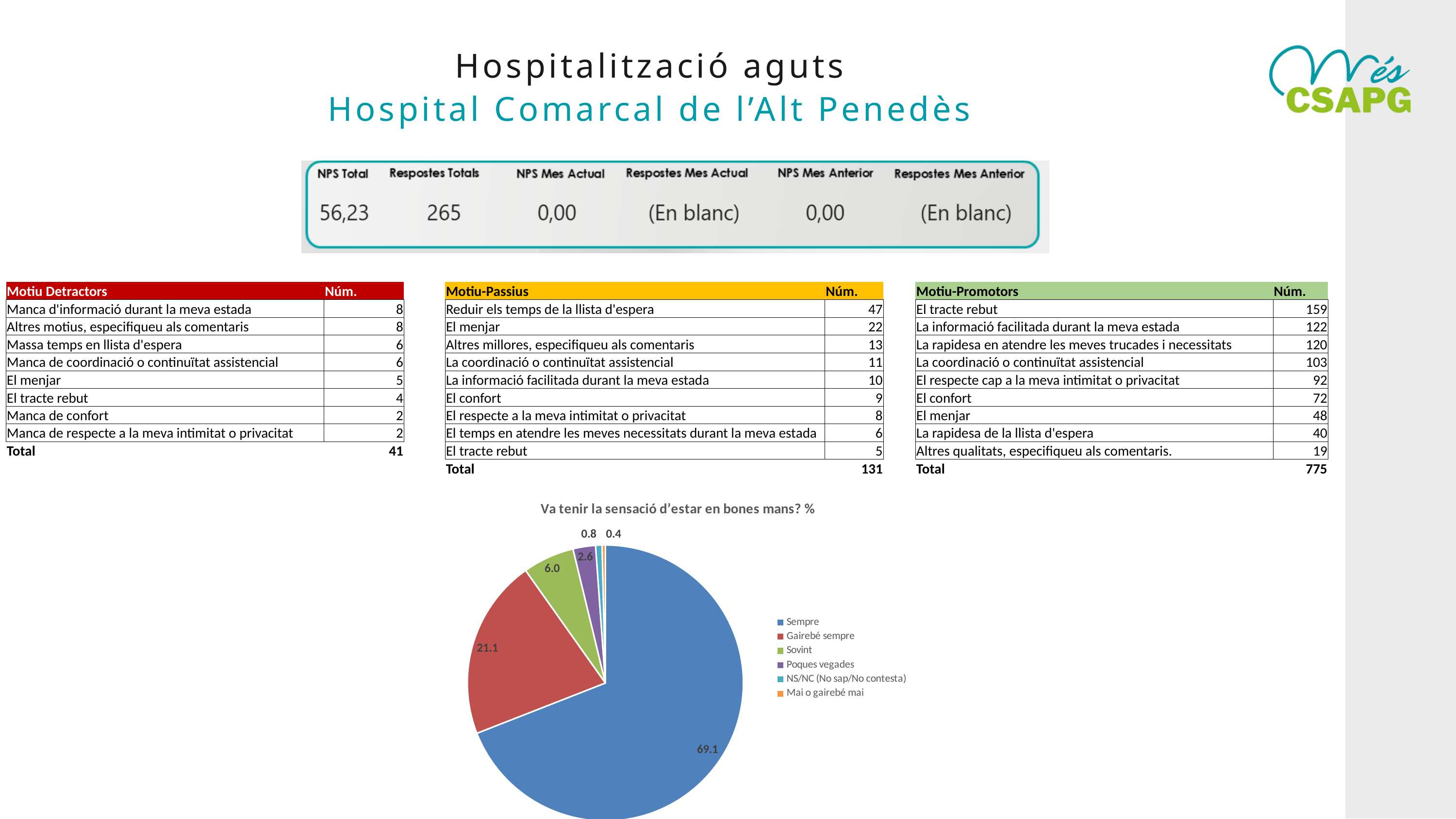
Which category has the smallest slice in the pie chart? Mai o gairebé mai How many categories does the legend of the pie chart list? 6 What is the value for 'Sovint' in the pie chart? 6.0 What is the value for 'Gairebé sempre' in the pie chart? 21.1 What is the difference between the values for 'Sempre' and 'Gairebé sempre' in the pie chart? 48.0 Which category has the largest slice in the pie chart? Sempre What is the value for 'Mai o gairebé mai' in the pie chart? 0.4 What is the value for 'Poques vegades' in the pie chart? 2.6 Which is larger in the pie chart, 'Sovint' or 'Poques vegades'? Sovint What type of chart is shown on the slide? pie chart What is the title of the pie chart? Va tenir la sensació d'estar en bones mans? % What is the value for 'Sempre' in the pie chart? 69.1